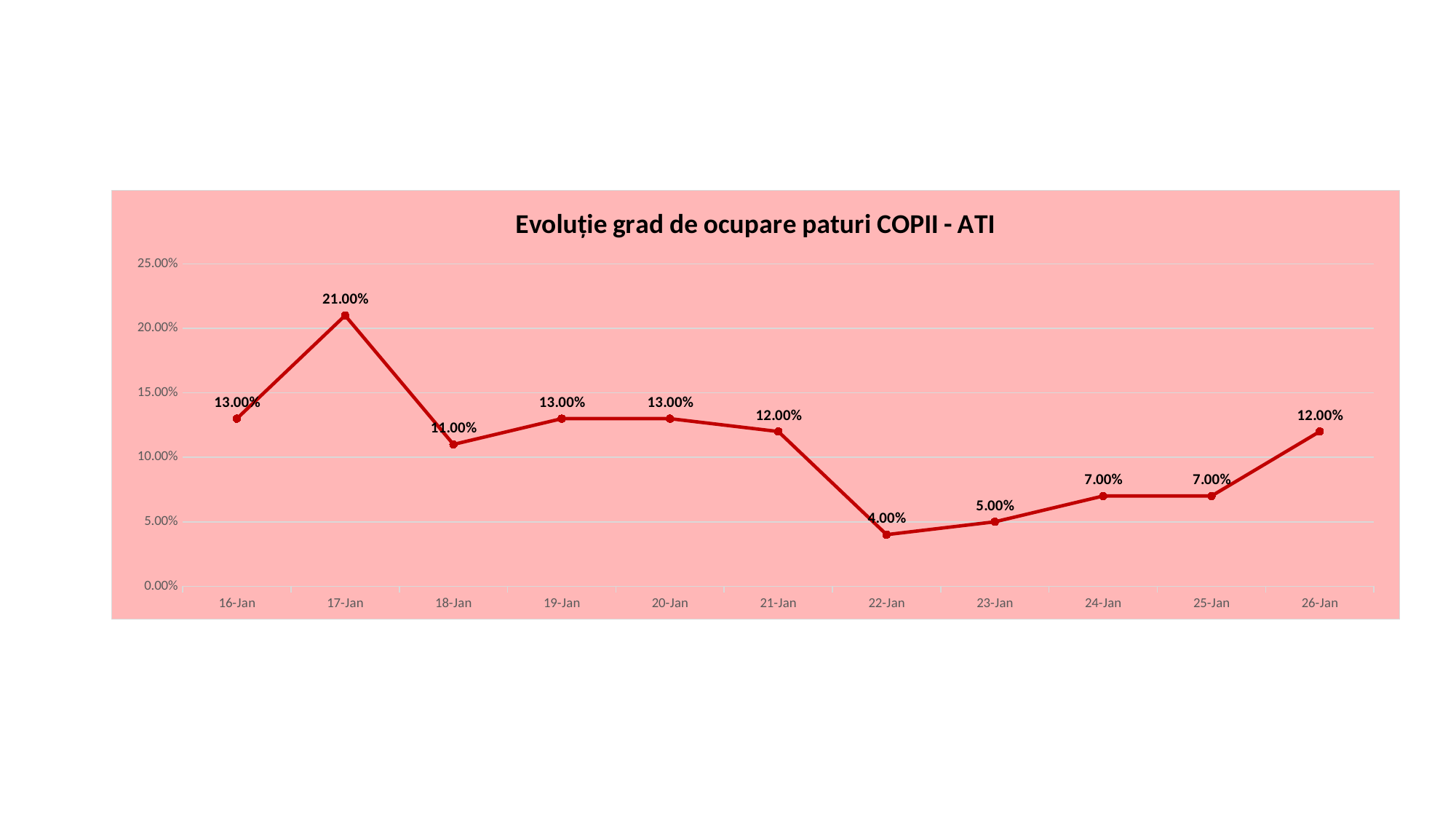
Is the value for 23-Jan greater or less than 10.00%? less What is the value for 26-Jan? 12.00% What is the difference between the values for 21-Jan and 22-Jan? 8.00% Which date has the lowest value? 22-Jan What is the value for 22-Jan? 4.00% How many dates are plotted on the x axis? 11 Which is larger, the value for 16-Jan or the value for 24-Jan? 16-Jan What is the difference between the values for 17-Jan and 18-Jan? 10.00% What is the title of the chart? Evoluție grad de ocupare paturi COPII - ATI What is the value for 17-Jan? 21.00% Which date has the highest value? 17-Jan What kind of chart is shown? line chart